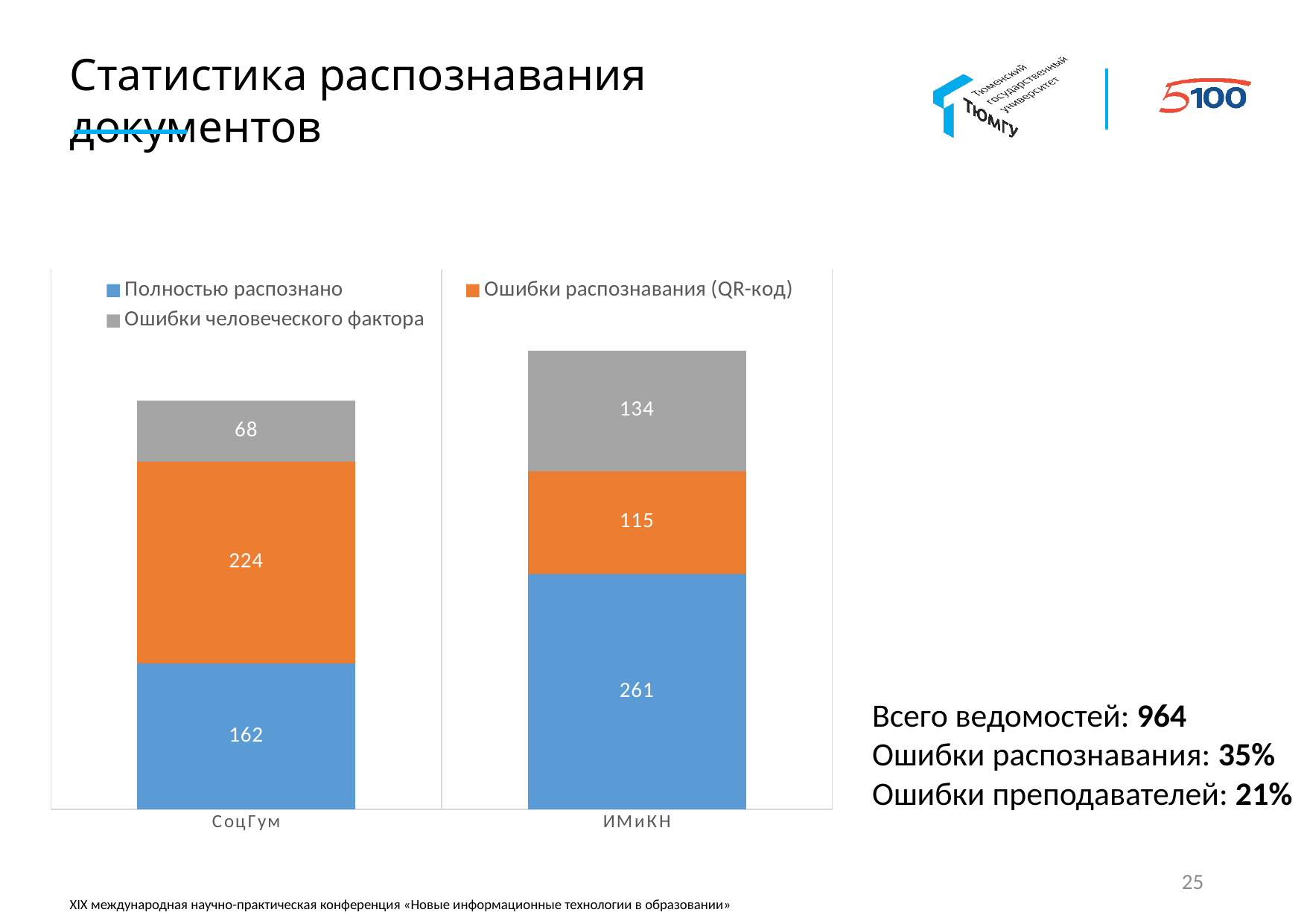
Which category has the larger "Ошибки распознавания (QR-код)" value, СоцГум or ИМиКН? СоцГум What is the total of the stacked bar for ИМиКН? 510 What is the value of "Ошибки распознавания (QR-код)" for ИМиКН? 115 How many series does the chart legend list? 3 What is the value of "Полностью распознано" for СоцГум? 162 What is the value of "Ошибки человеческого фактора" for ИМиКН? 134 How many categories are shown on the x axis of the chart? 2 What is the value of "Ошибки человеческого фактора" for СоцГум? 68 Which colour represents the "Полностью распознано" series in the chart? Blue What is the total of the stacked bar for СоцГум? 454 What is the difference between the "Полностью распознано" values for ИМиКН and СоцГум? 99 What kind of chart is shown on the slide? Stacked bar chart